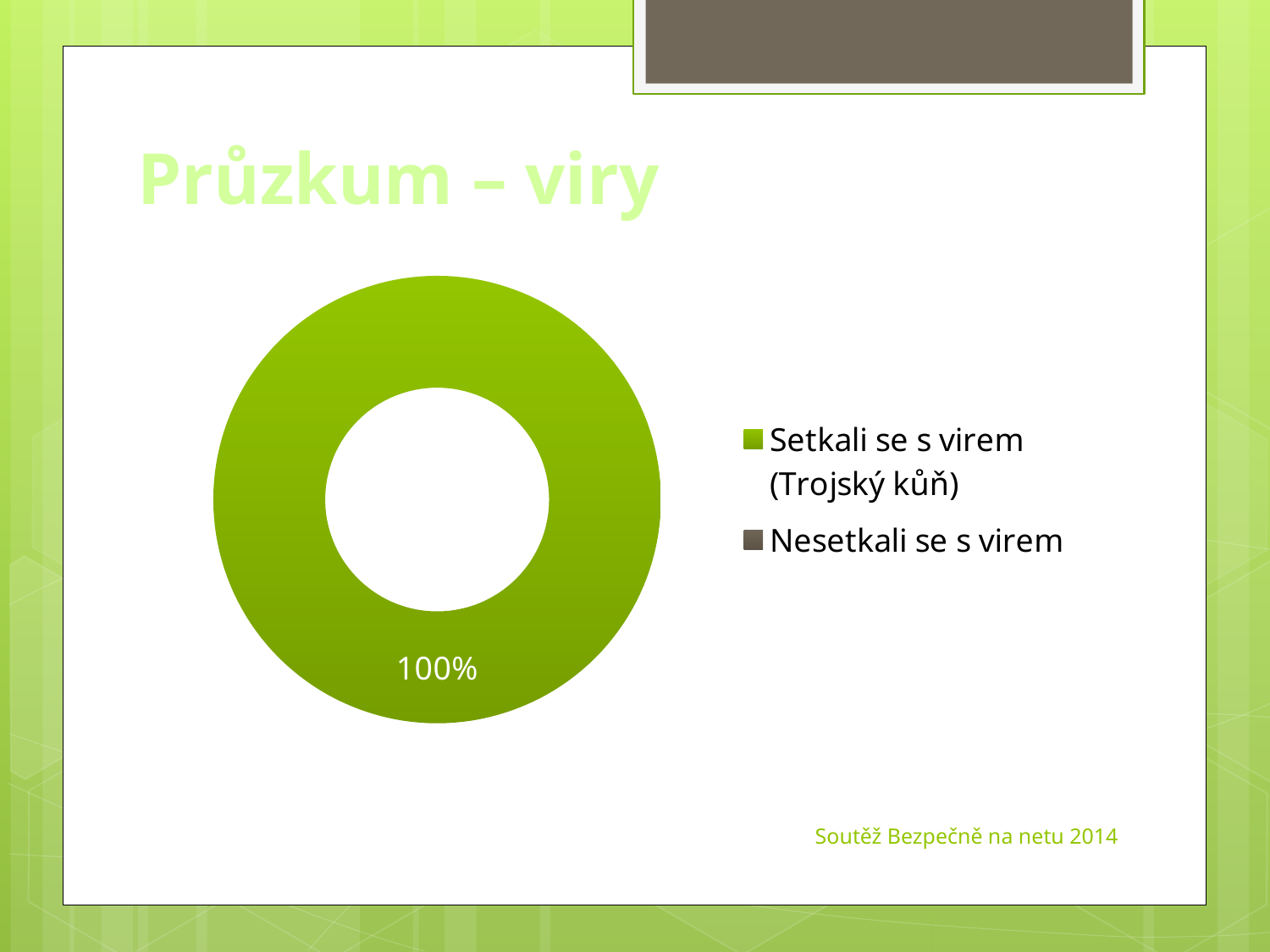
What share of the doughnut chart does the 'Setkali se s virem (Trojský kůň)' slice take? 100% What colour represents 'Setkali se s virem (Trojský kůň)' in the legend? green What is the title of the slide containing the chart? Průzkum – viry Which category has the largest share in the chart? Setkali se s virem (Trojský kůň) How many entries does the chart legend list? 2 What kind of chart is shown on the slide? doughnut chart Which category has the smallest share in the chart? Nesetkali se s virem What value is printed on the green slice of the chart? 100% Which is larger, the share for 'Setkali se s virem (Trojský kůň)' or for 'Nesetkali se s virem'? Setkali se s virem (Trojský kůň)